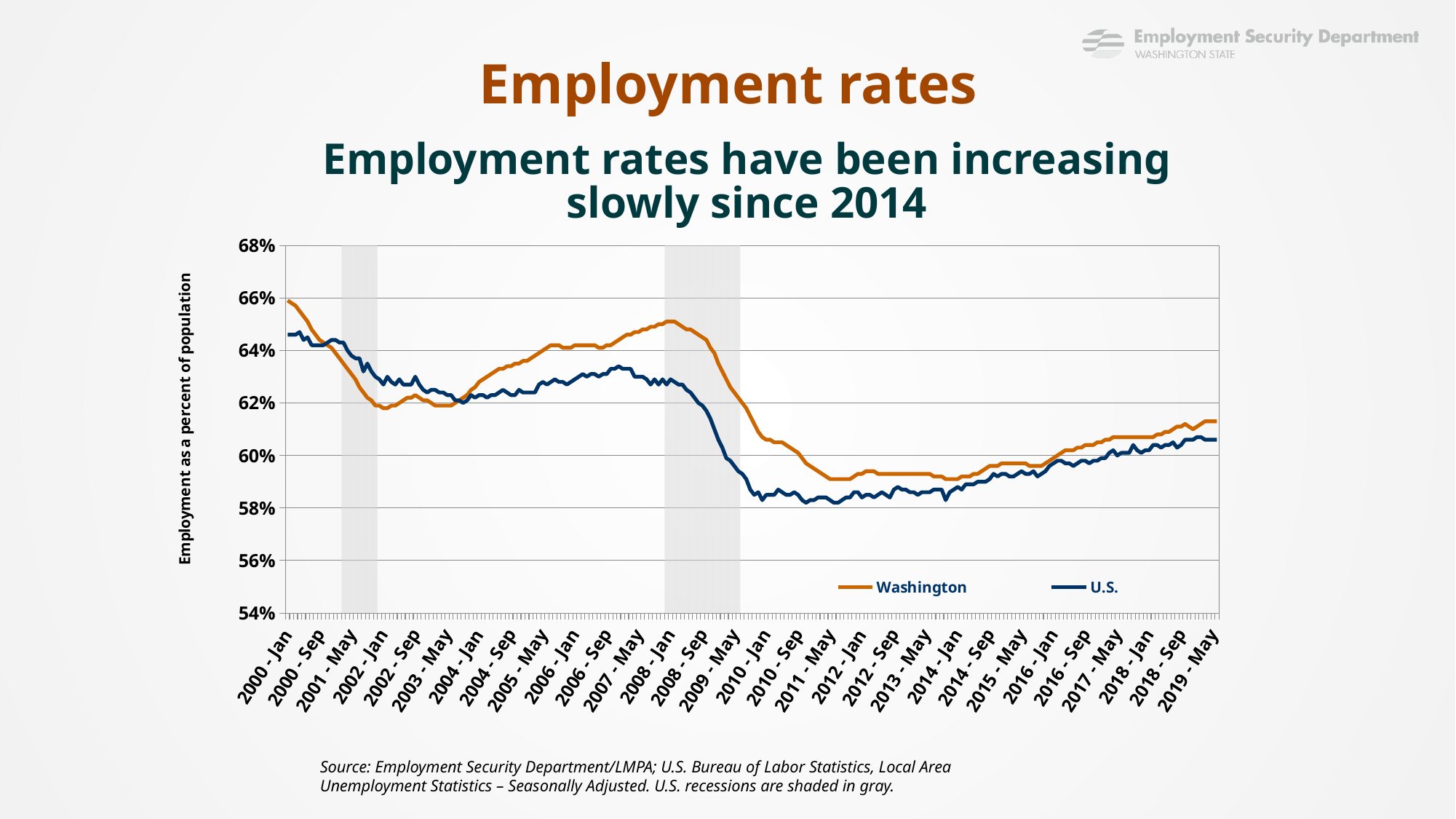
What is the label of the vertical axis? Employment as a percent of population Do the U.S. values rise or fall between 2008 - Jan and 2010 - Jan? fall Is the U.S. value at 2019 - May greater or less than 62%? less At 2019 - May, which series has the higher value, Washington or U.S.? Washington How many series does the legend list? 2 Is the Washington value at 2019 - May greater or less than 60%? greater At 2001 - May, which series has the higher value, Washington or U.S.? U.S. Is the Washington value at 2000 - Jan greater or less than 64%? greater What kind of chart is shown on the slide? line chart Do the Washington values rise or fall between 2014 - Jan and 2019 - May? rise What is the title of the chart on the slide? Employment rates